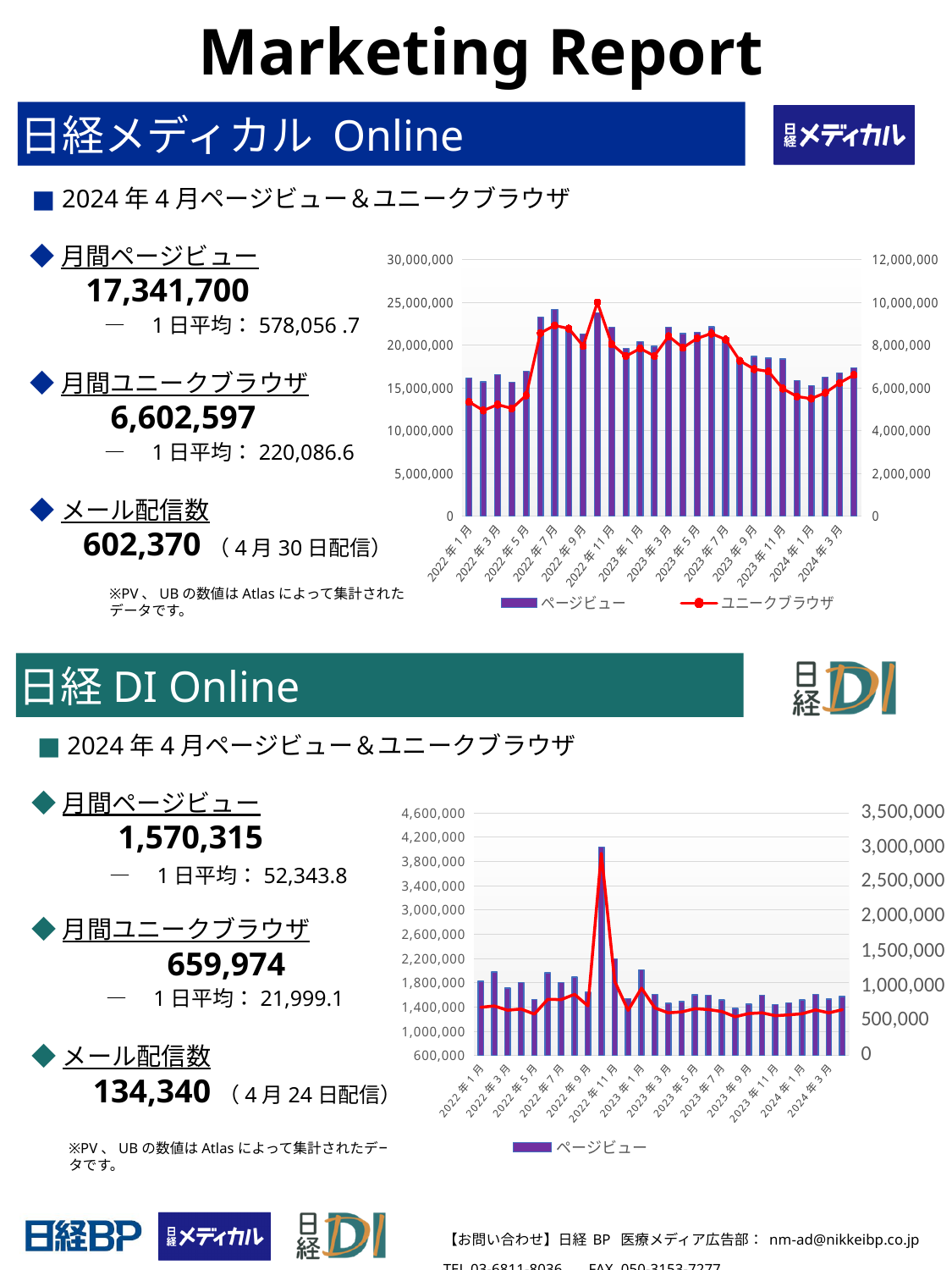
In the 日経 DI Online chart (bottom chart), is the page view bar for 2022年1月 greater or less than 1,400,000? greater In the 日経メディカル Online chart (top chart), is the page view bar for 2022年1月 greater or less than 20,000,000? less In the 日経 DI Online chart (bottom chart), is the tallest page view bar greater or less than 3,800,000? greater In the 日経メディカル Online chart (top chart), which page view bar is taller, 2022年7月 or 2024年1月? 2022年7月 How many series does the legend of the 日経 DI Online chart (bottom chart) list? 1 What is the maximum value shown on the right axis of the 日経メディカル Online chart (top chart)? 12,000,000 In the 日経メディカル Online chart (top chart), do the page view bars rise or fall from 2023年5月 to 2024年1月? fall How many series does the legend of the 日経メディカル Online chart (top chart) list? 2 What kind of chart is the 日経メディカル Online chart (top chart)? Combined bar and line chart What is the maximum value shown on the left axis of the 日経 DI Online chart (bottom chart)? 4,600,000